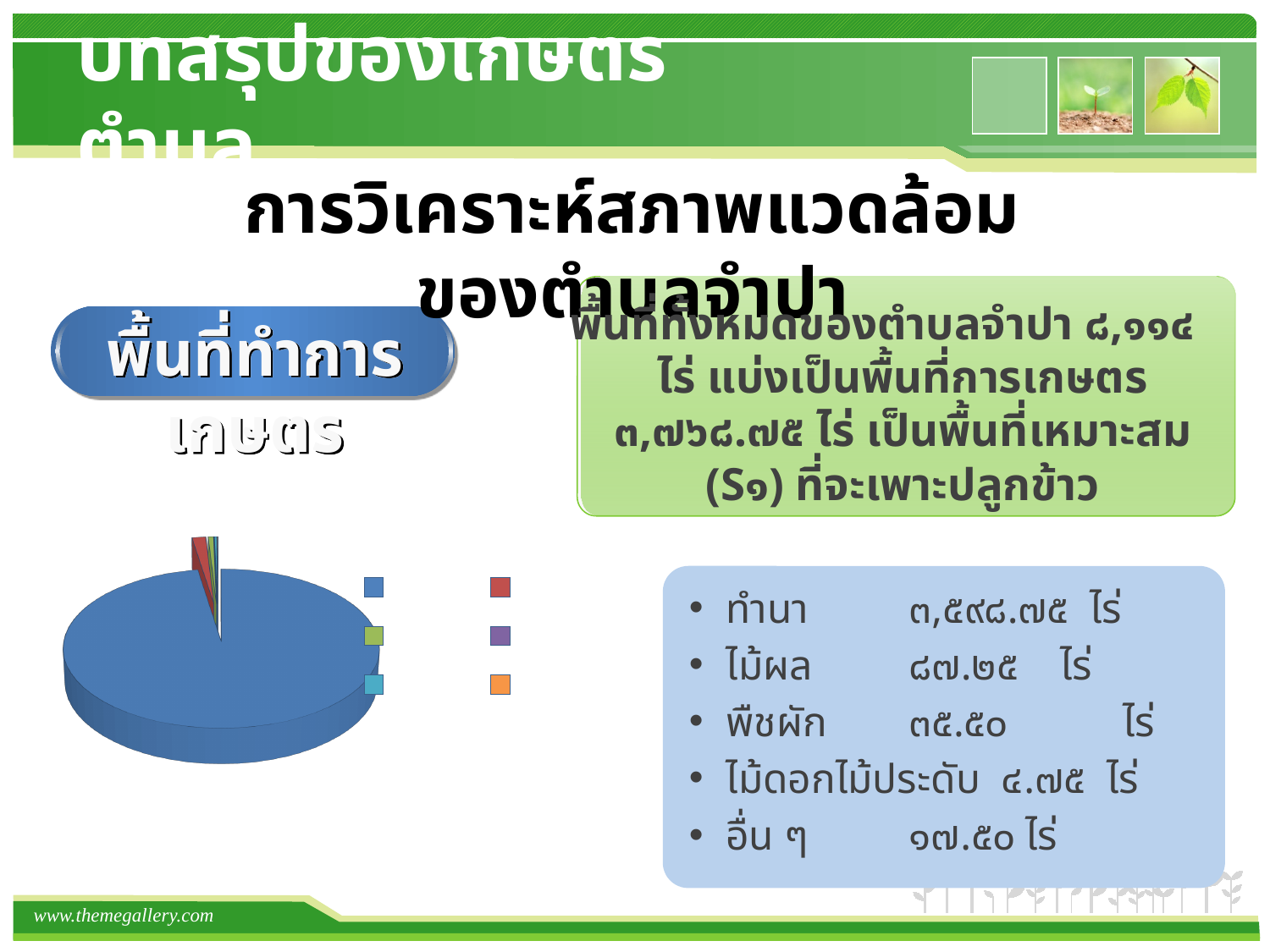
Which colour slice is the largest in the pie chart? blue Does the largest (blue) slice of the pie chart take up more or less than half of the pie? more Are the legend entries of the pie chart labelled with text? No How many entries does the legend of the pie chart list? 6 What kind of chart is shown on the slide? pie chart